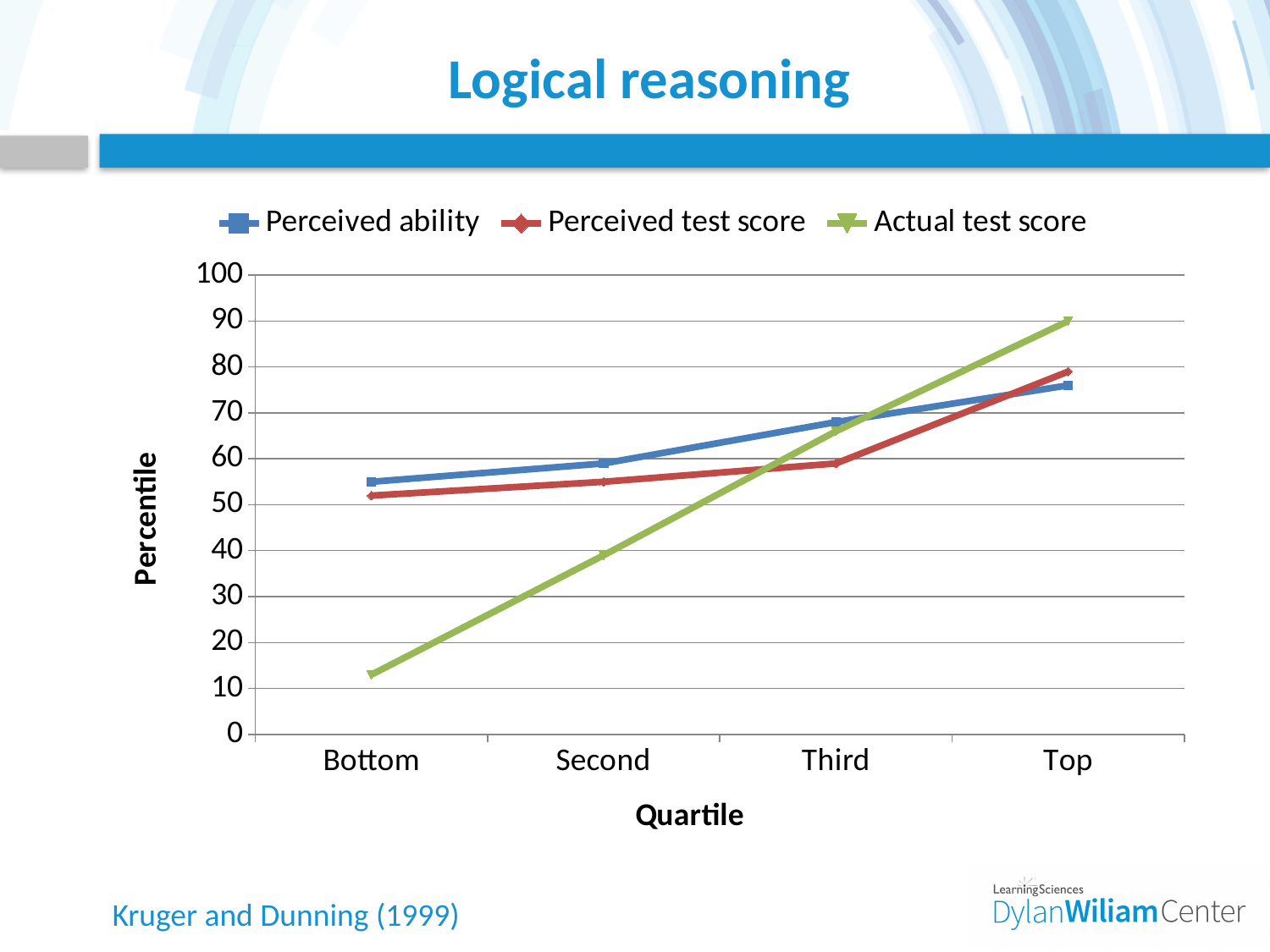
What kind of chart is shown on the slide? line chart For the Top quartile, which is larger: Actual test score or Perceived ability? Actual test score Is the Actual test score for the Bottom quartile greater or less than 20? less Is the Actual test score for the Second quartile greater or less than 50? less Is the Actual test score for the Top quartile greater or less than 80? greater Does the Actual test score rise or fall from the Bottom quartile to the Top quartile? rise For the Bottom quartile, which is larger: Perceived ability or Actual test score? Perceived ability How many series does the legend list? 3 What is the label on the y axis of the chart? Percentile How many quartile categories are shown on the x axis? 4 Which quartile has the lowest Actual test score? Bottom